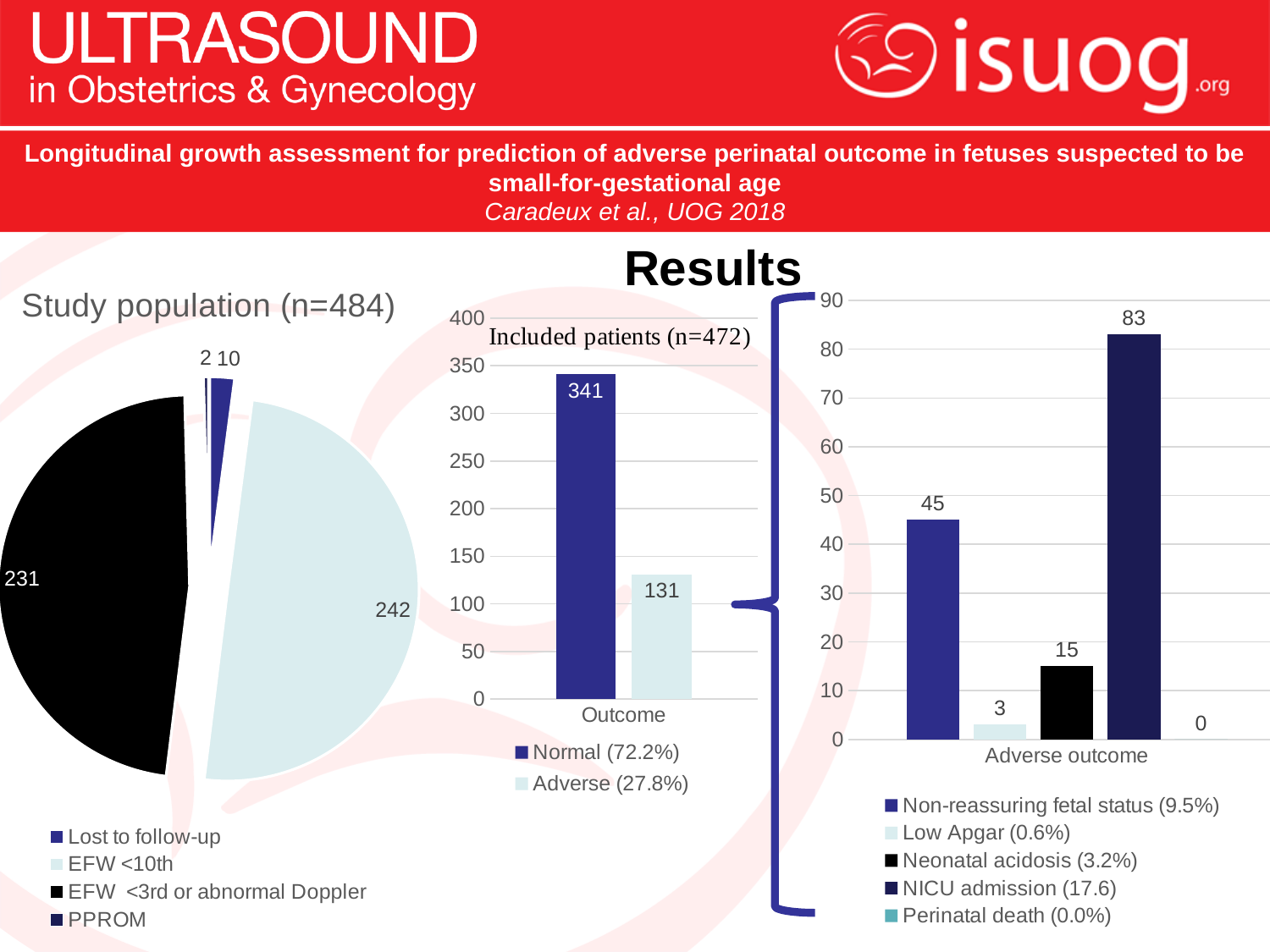
In the 'Included patients (n=472)' bar chart, what is the difference between the Normal and Adverse values? 210 In the 'Included patients (n=472)' bar chart, what is the value for Adverse? 131 In the 'Adverse outcome' bar chart on the right, which category has the highest value? NICU admission What kind of chart is the 'Study population (n=484)' chart? Pie chart In the 'Study population (n=484)' pie chart, which is larger: EFW <10th or EFW <3rd or abnormal Doppler? EFW <10th In the 'Included patients (n=472)' bar chart, what is the value for Normal? 341 In the 'Study population (n=484)' chart, what is the value for EFW <10th? 242 In the 'Adverse outcome' bar chart on the right, what is the difference between Non-reassuring fetal status and Low Apgar? 42 In the 'Adverse outcome' bar chart on the right, how many series does the legend list? 5 In the 'Adverse outcome' bar chart on the right, what is the value for NICU admission? 83 In the 'Adverse outcome' bar chart on the right, what is the value for Neonatal acidosis? 15 In the 'Adverse outcome' bar chart on the right, which category has the lowest value? Perinatal death